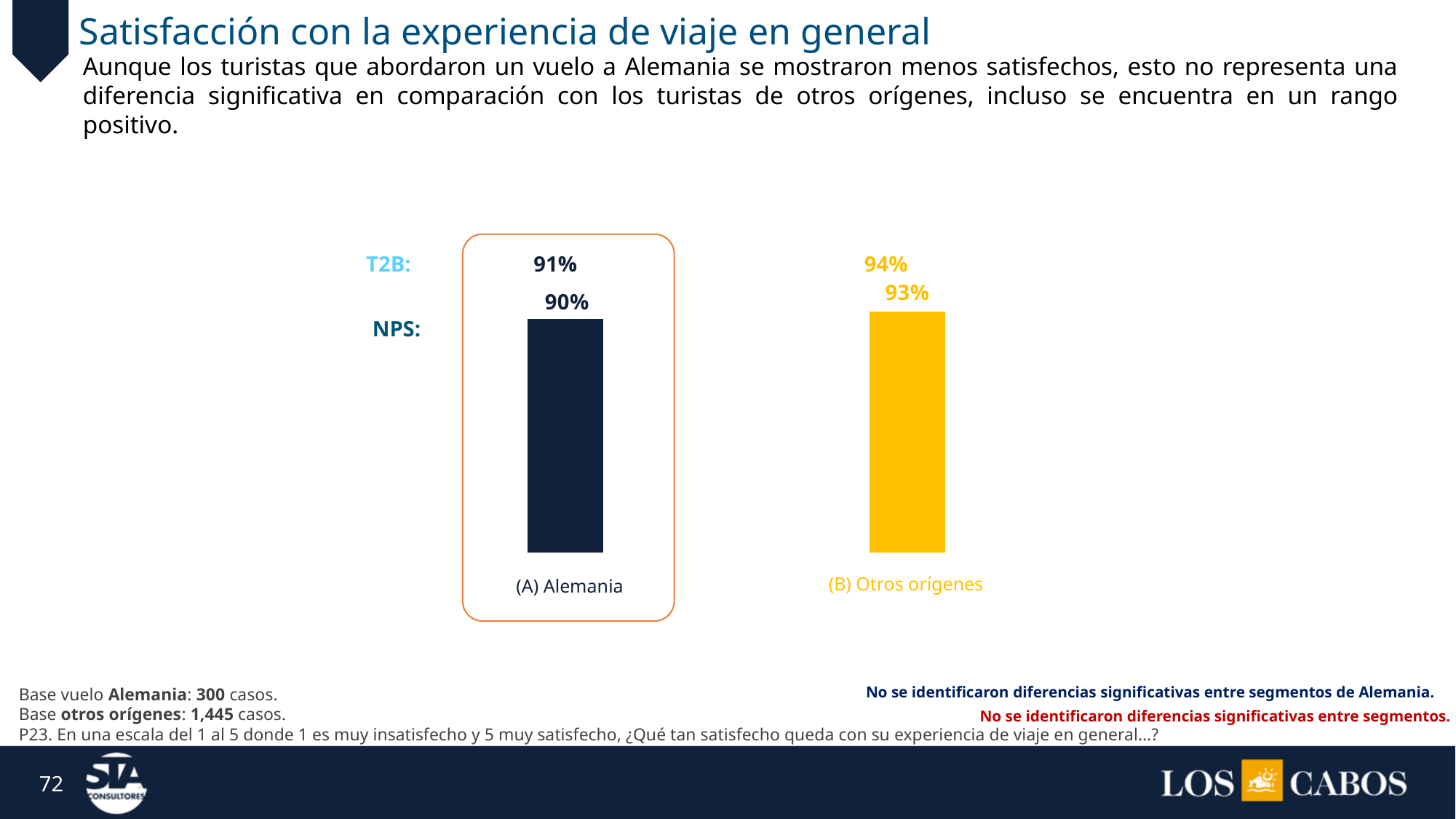
What is the difference between the bar values for (B) Otros orígenes and (A) Alemania? 3% Which category has the higher bar value, (A) Alemania or (B) Otros orígenes? (B) Otros orígenes What is the value shown on the bar for (A) Alemania? 90% What is the T2B value shown for (A) Alemania? 91% What colour is the bar for (B) Otros orígenes? Yellow What kind of chart is shown on the slide? Bar chart What is the T2B value shown for (B) Otros orígenes? 94% What is the difference between the T2B values for (B) Otros orígenes and (A) Alemania? 3% Which category's bar is enclosed in an orange outlined box? (A) Alemania Which category has the lowest bar value? (A) Alemania What is the value shown on the bar for (B) Otros orígenes? 93% How many categories are plotted in the chart? 2